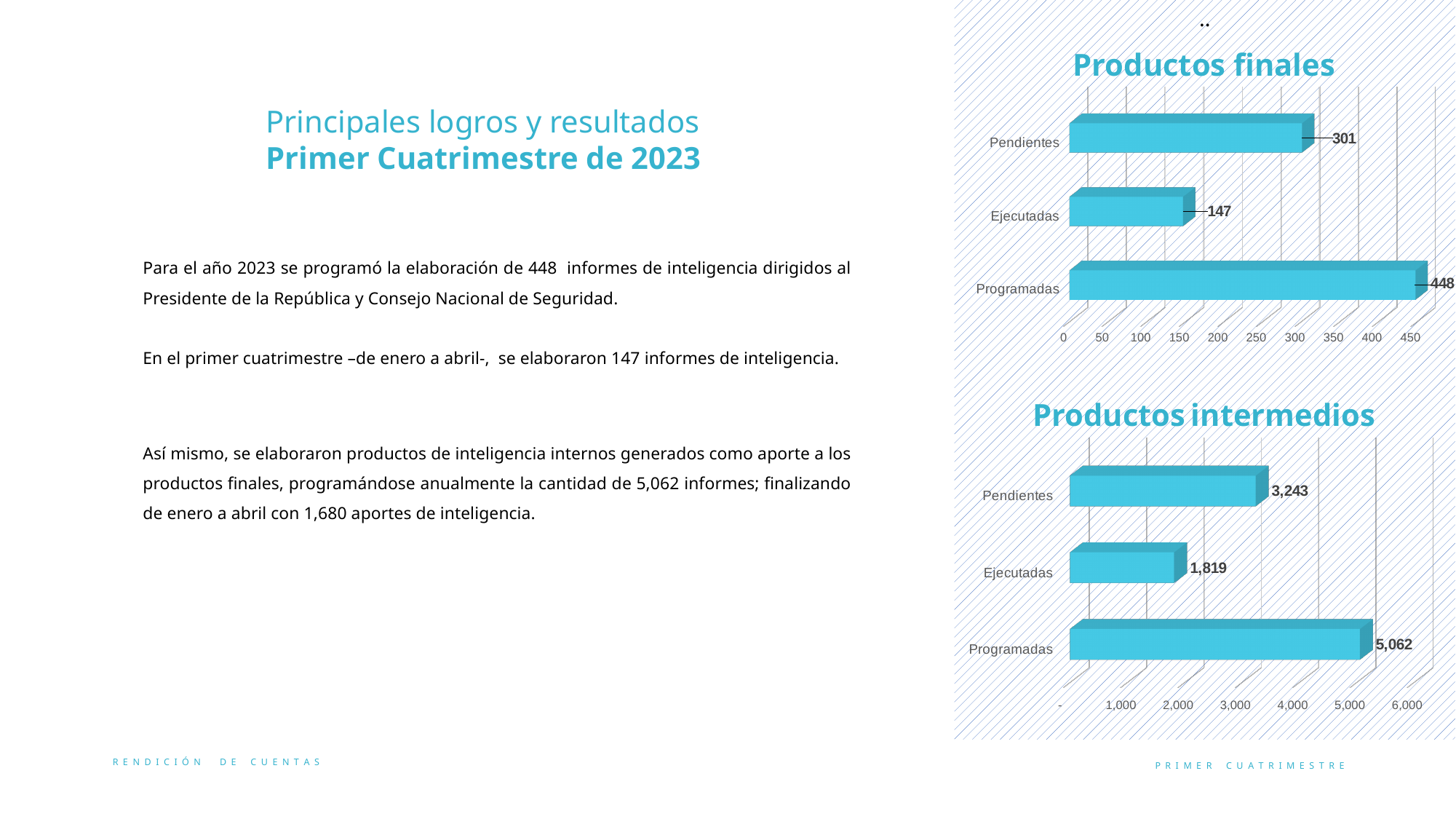
In the 'Productos intermedios' chart, what is the difference between Pendientes and Ejecutadas? 1,424 In the 'Productos intermedios' chart, is the value for Pendientes greater or less than 3,000? greater In the 'Productos finales' chart, what is the value for Pendientes? 301 In the 'Productos finales' chart, which category has the highest value? Programadas How many categories does the 'Productos finales' chart show? 3 What kind of chart is the 'Productos intermedios' chart? bar chart In the 'Productos finales' chart, which category has the lowest value? Ejecutadas In the 'Productos finales' chart, what is the difference between Programadas and Ejecutadas? 301 In the 'Productos intermedios' chart, what is the value for Ejecutadas? 1,819 In the 'Productos intermedios' chart, which is larger, Pendientes or Ejecutadas? Pendientes In the 'Productos finales' chart, what is the value for Ejecutadas? 147 In the 'Productos intermedios' chart, what is the value for Programadas? 5,062